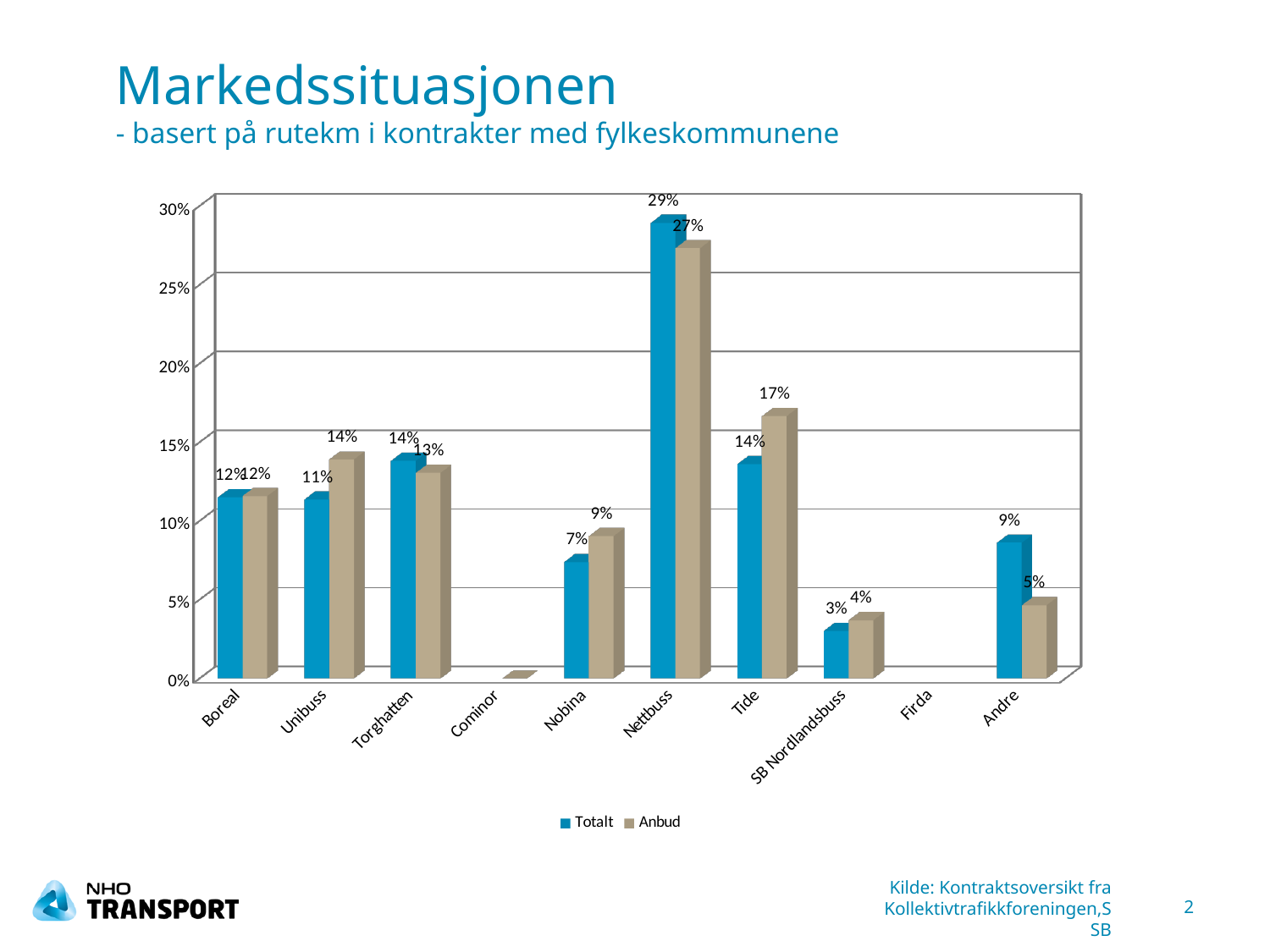
What is the Totalt value for Nettbuss? 29% What is the Totalt value for Nobina? 7% What is the difference between the Anbud values for Tide and Unibuss? 3% How many categories are shown on the x axis? 10 What is the Anbud value for Andre? 5% What kind of chart is shown on the slide? Bar chart What is the Anbud value for Tide? 17% Which category has the highest Anbud value? Nettbuss Which category has the highest Totalt value? Nettbuss Which is larger for Unibuss, the Totalt value or the Anbud value? Anbud How many series does the legend list? 2 What is the difference between the Totalt and Anbud values for Andre? 4%